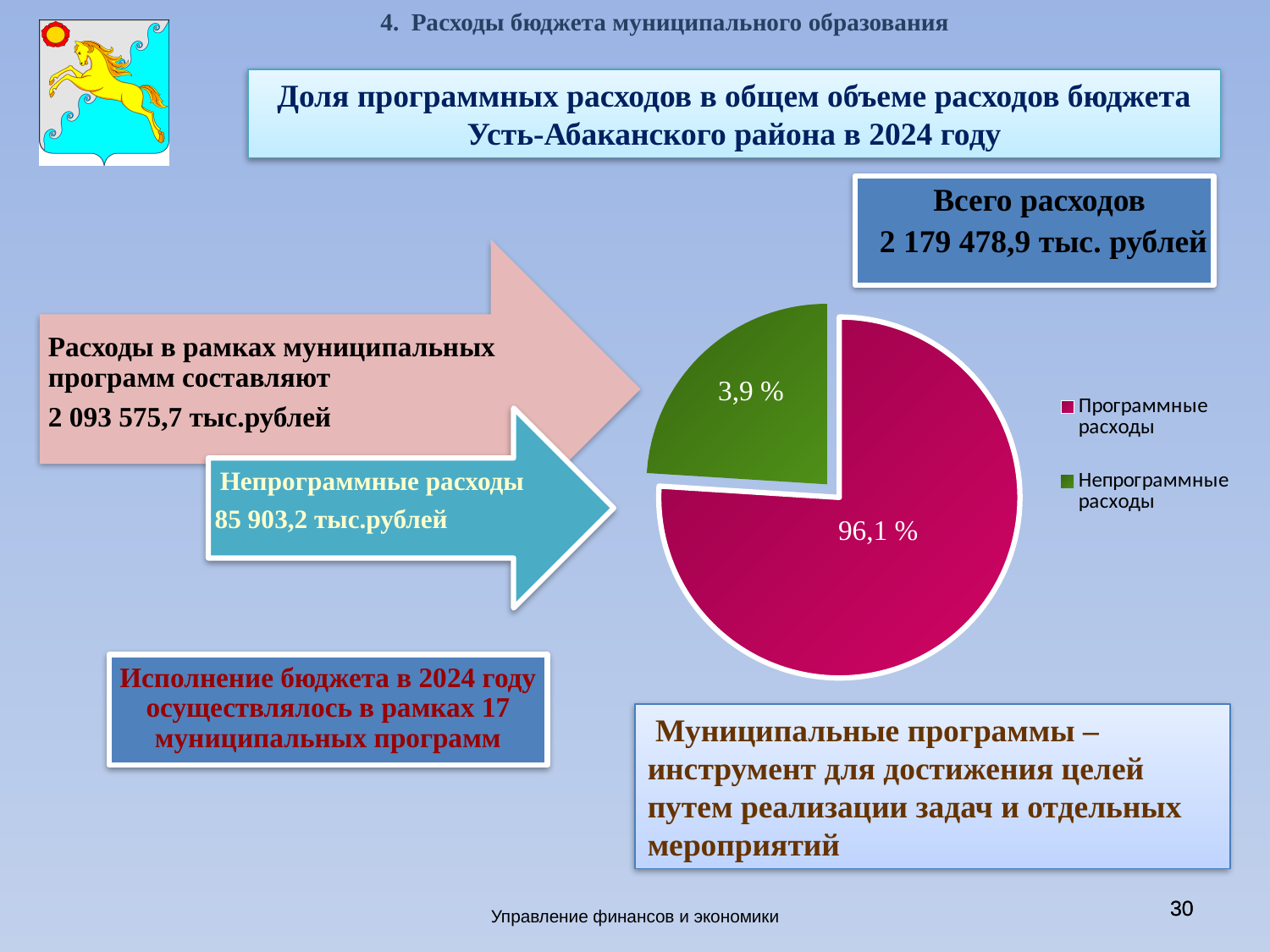
Which slice of the pie chart is the smallest? Непрограммные расходы What share of the pie chart is labelled for Непрограммные расходы? 3,9 % Which slice of the pie chart is the largest? Программные расходы What colour is the Программные расходы slice in the pie chart? magenta (crimson) What share of the pie chart is labelled for Программные расходы? 96,1 % How many entries does the legend of the pie chart list? 2 What colour is the Непрограммные расходы slice in the pie chart? green By how many percentage points does the Программные расходы slice exceed the Непрограммные расходы slice? 92,2 % How many slices does the pie chart have? 2 Which is larger in the pie chart: Программные расходы or Непрограммные расходы? Программные расходы Is the share for Непрограммные расходы greater or less than 10 %? less What kind of chart is shown on the slide? pie chart